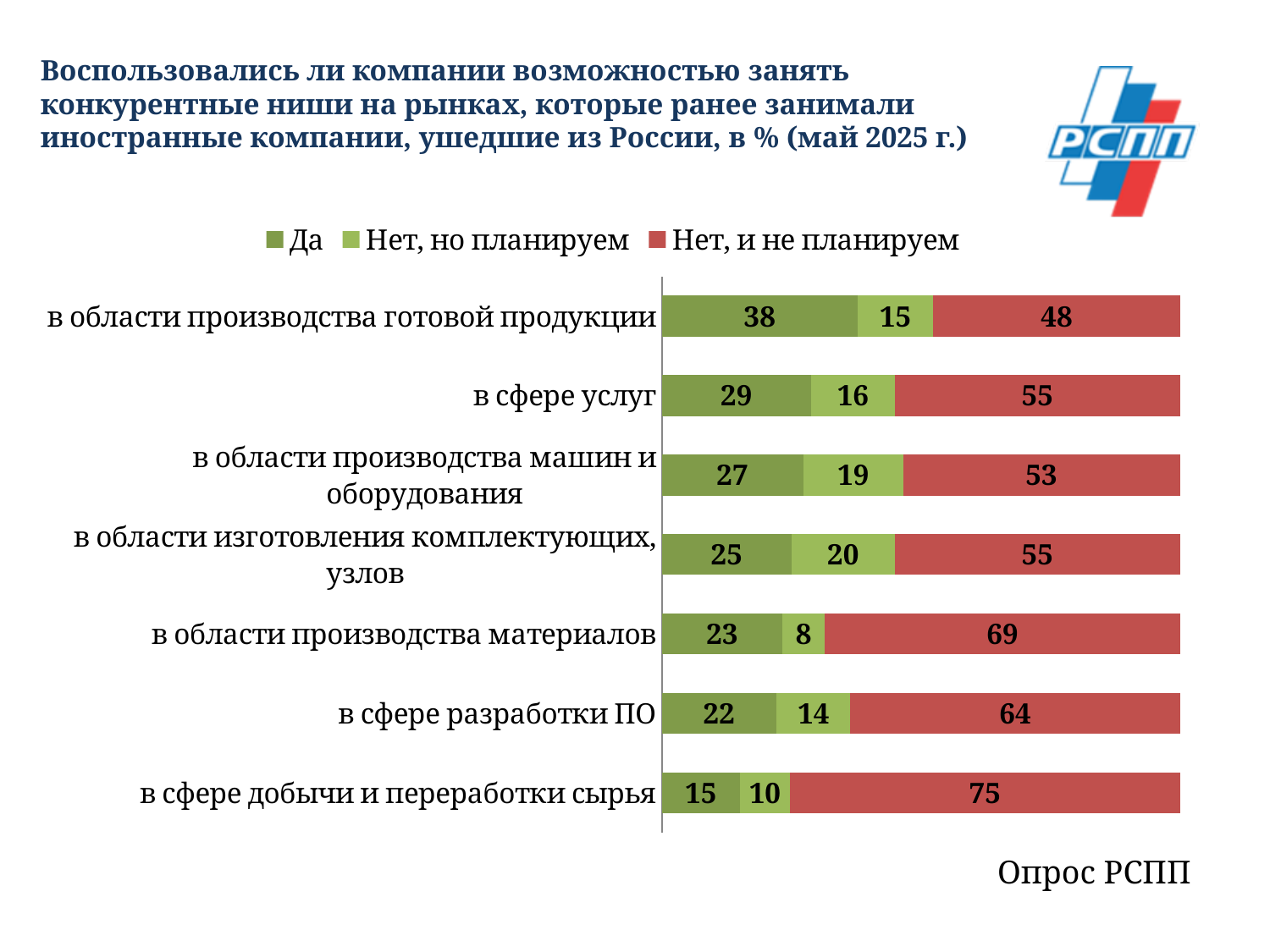
What type of chart is shown on the slide? stacked bar chart What is the difference between the "Нет, и не планируем" values for "в области производства материалов" and "в области производства готовой продукции"? 21 What is the total of the stacked bar for "в области производства готовой продукции"? 101 What is the value of "Нет, и не планируем" for "в сфере разработки ПО"? 64 How many series does the legend list? 3 Which category has the lowest value for "Да"? в сфере добычи и переработки сырья How many categories are shown in the chart? 7 What is the value of "Да" for "в области производства готовой продукции"? 38 Which is larger: the "Да" value for "в сфере услуг" or for "в области производства машин и оборудования"? в сфере услуг Which category has the highest value for "Нет, и не планируем"? в сфере добычи и переработки сырья Which legend entry is shown in red? Нет, и не планируем What is the value of "Нет, но планируем" for "в области изготовления комплектующих, узлов"? 20